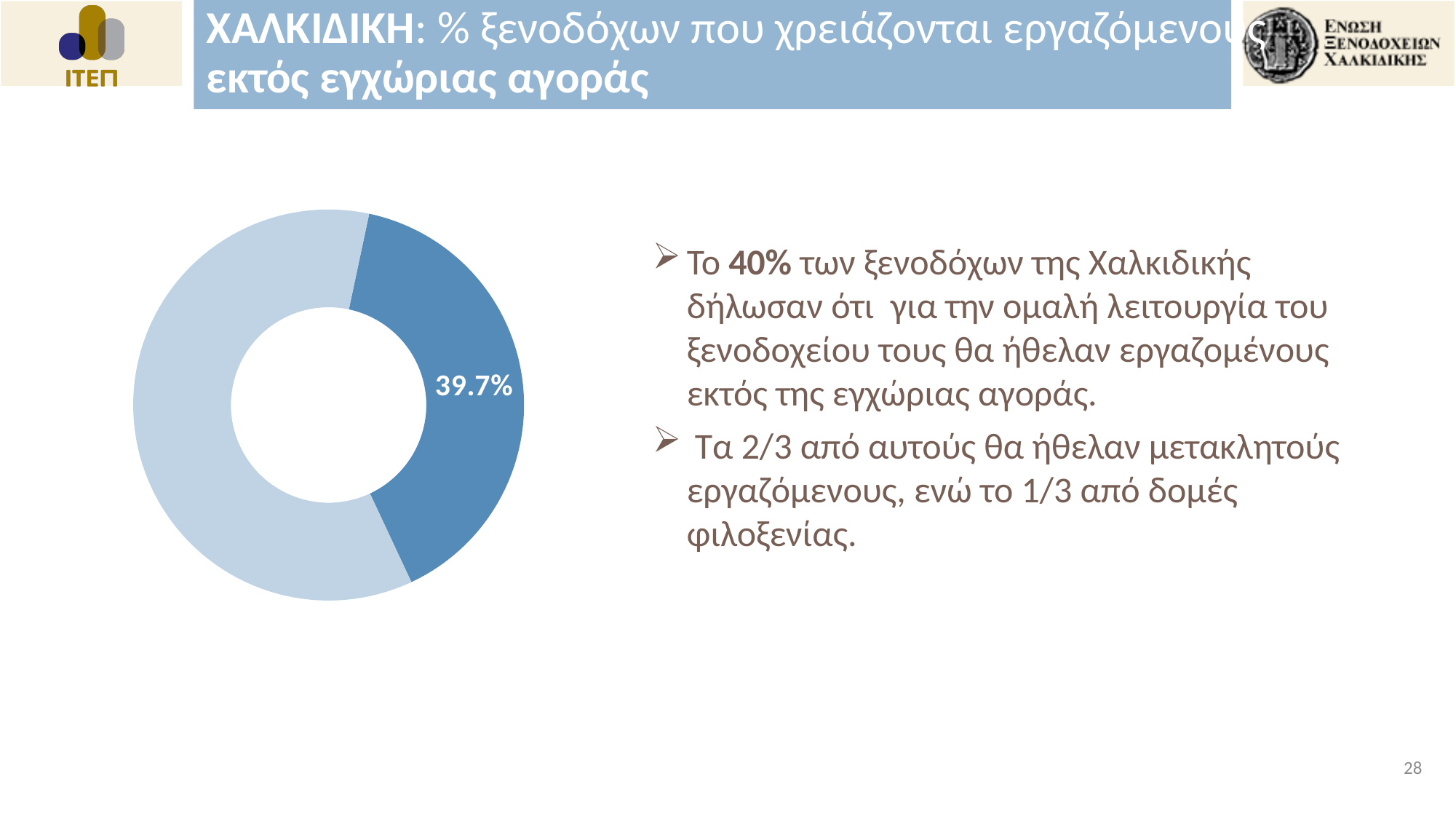
How many slices does the donut chart have? 2 What value is printed on the dark blue slice of the donut chart? 39.7% What share of the donut chart does the dark blue slice represent? 39.7% What kind of chart is shown on the slide? Donut (pie) chart What colour is the slice that carries the 39.7% label? Dark blue Is the value of the dark blue slice greater or less than 50%? less How many data labels are printed on the donut chart? 1 Which slice of the donut chart is larger, the dark blue one or the light blue one? The light blue one